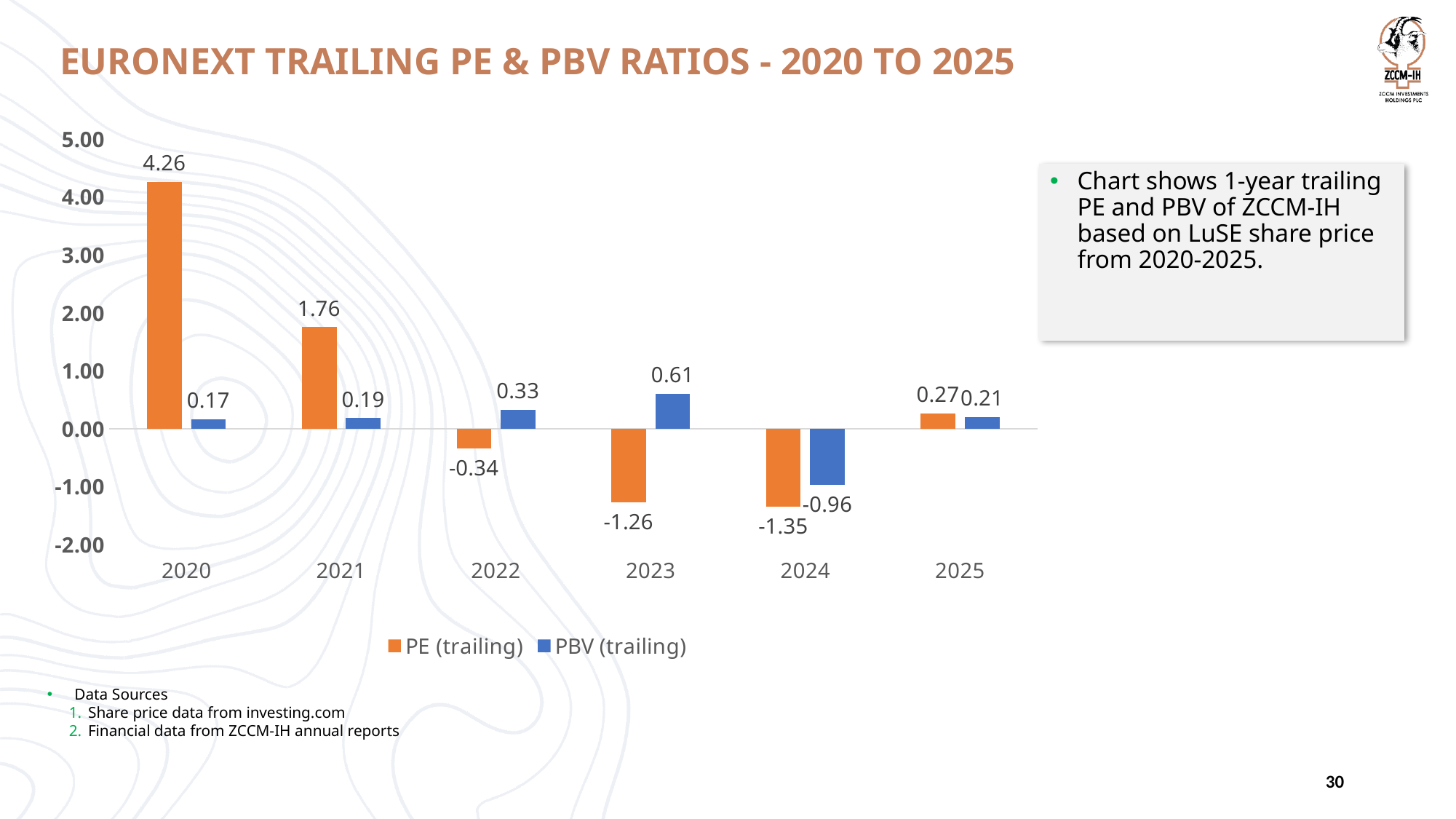
How many series does the legend list? 2 What is the difference between the PE (trailing) values for 2020 and 2021? 2.50 What kind of chart is shown on the slide? Bar chart What is the PBV (trailing) value for 2023? 0.61 Which year has the larger PBV (trailing) value, 2021 or 2022? 2022 What is the PE (trailing) value for 2024? -1.35 How many years are shown on the x axis? 6 Which year has the lowest PE (trailing) value? 2024 Which year has the highest PBV (trailing) value? 2023 What is the PE (trailing) value for 2020? 4.26 Which year has the lowest PBV (trailing) value? 2024 Which year has the highest PE (trailing) value? 2020